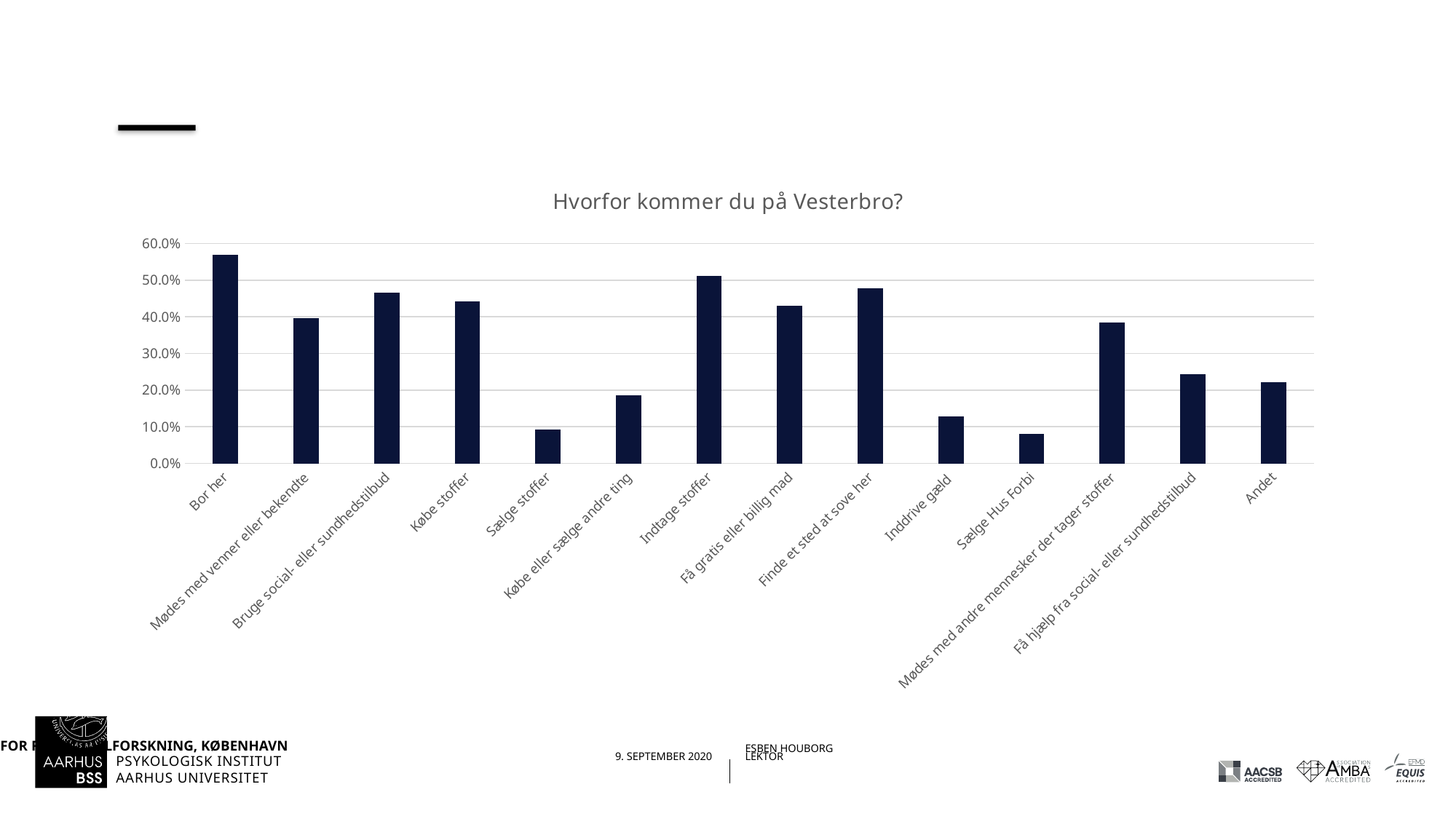
Which is larger, the value for Købe stoffer or the value for Sælge stoffer? Købe stoffer Which category has the highest value in the chart? Bor her How many categories are shown on the x axis of the chart? 14 Is the value for Få hjælp fra social- eller sundhedstilbud greater or less than 30.0%? less Is the value for Indtage stoffer greater or less than 40.0%? greater Is the value for Bor her greater or less than 50.0%? greater Which is larger, the value for Bor her or the value for Indtage stoffer? Bor her What is the title of the chart? Hvorfor kommer du på Vesterbro? What kind of chart is shown on the slide? bar chart